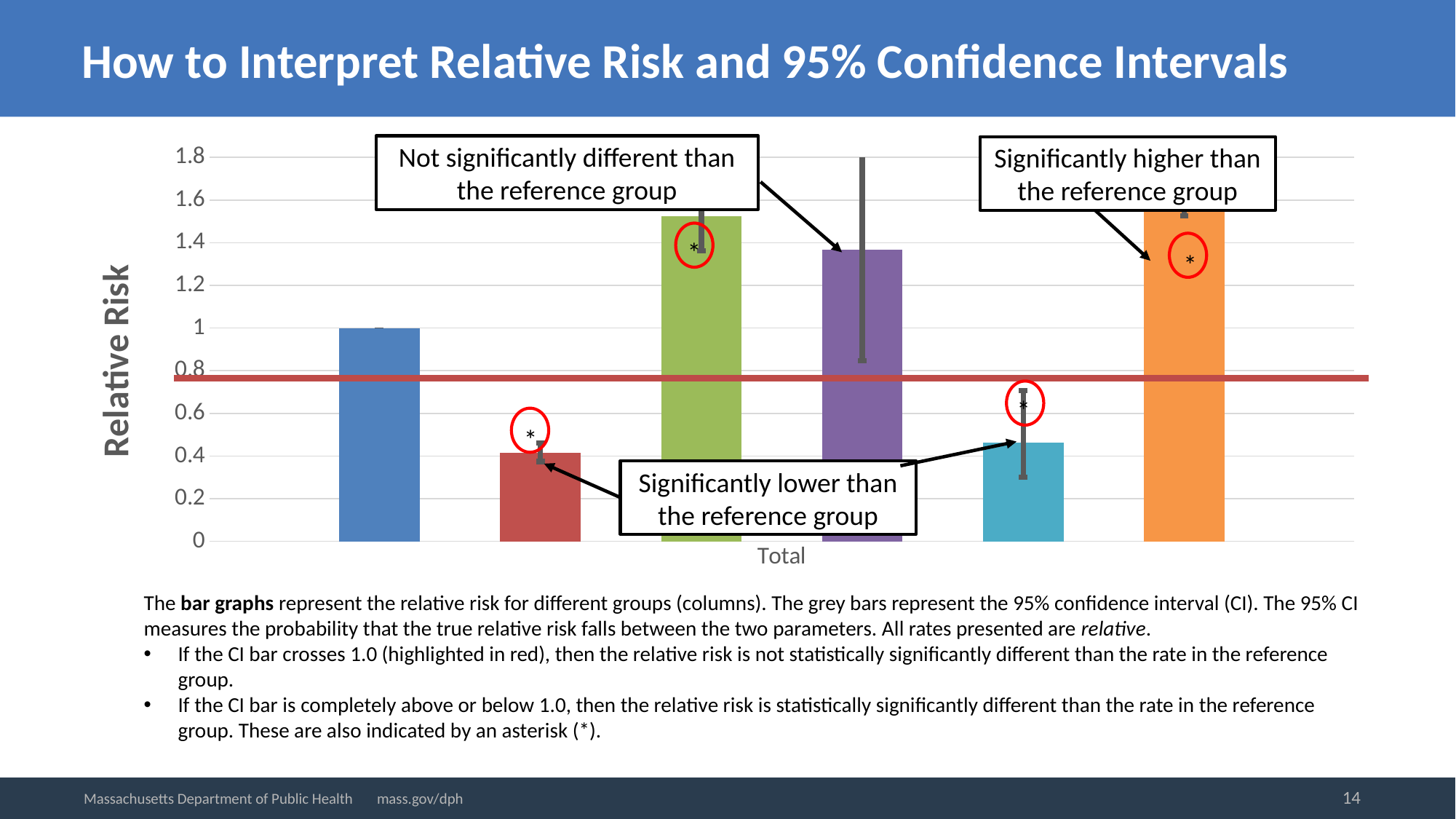
Is the value of the green bar greater or less than 1.4? greater Which bar is taller, the green bar or the purple bar? the green bar What is the value of the blue bar (the first bar) in the chart? 1 Which bar is taller, the blue bar or the red bar? the blue bar Is the value of the orange bar greater or less than 1.4? greater What is the title of the vertical axis of the chart? Relative Risk What kind of chart is shown on the slide? bar chart Is the value of the teal bar greater or less than 0.8? less What category label appears on the horizontal axis of the chart? Total How many bars are plotted in the chart? 6